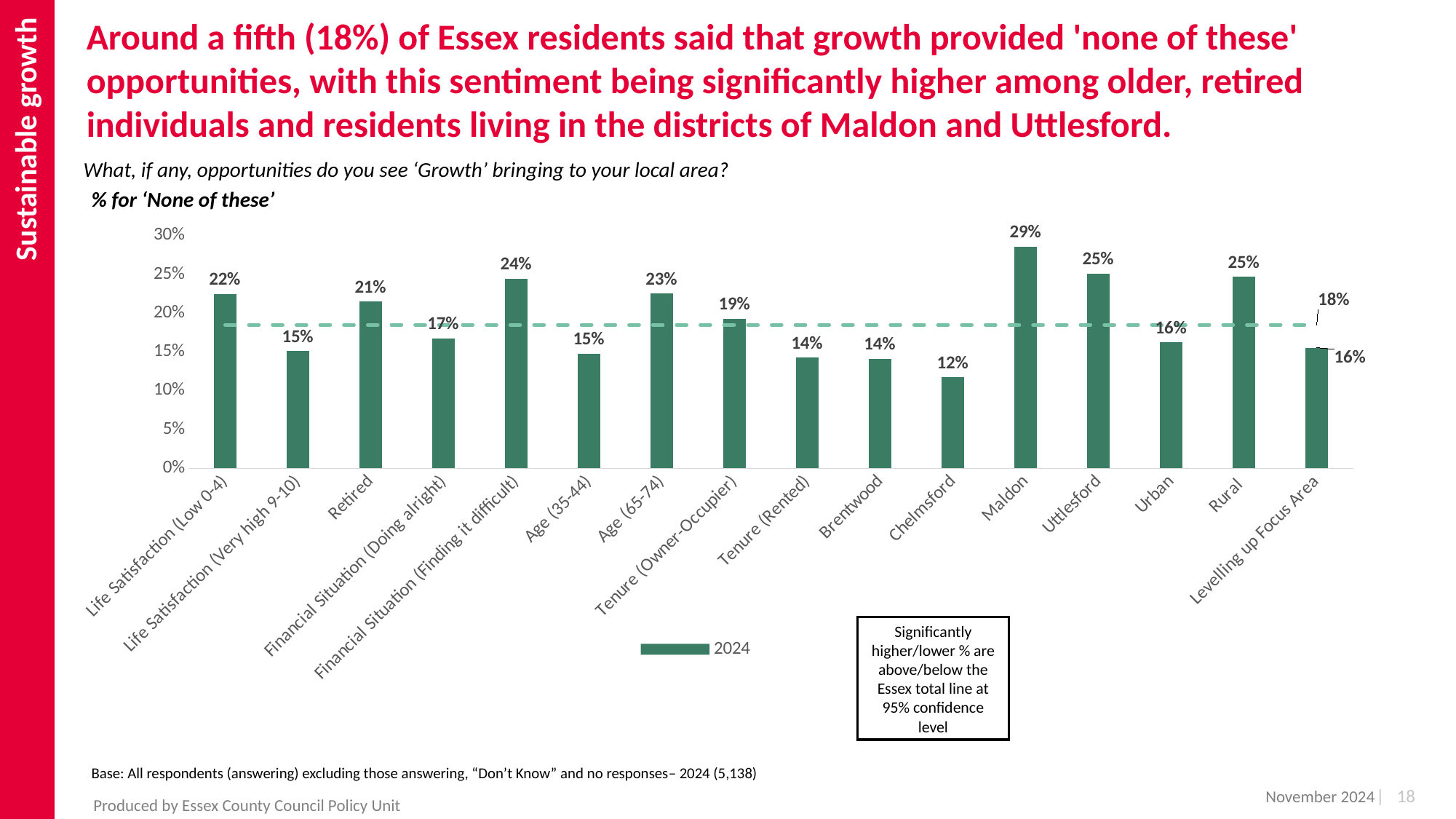
What is the value for Maldon? 29% What value does the dashed horizontal line (Essex total) represent? 18% What is the value for Tenure (Owner-Occupier)? 19% What is the value for Chelmsford? 12% What is the value for Financial Situation (Finding it difficult)? 24% How many series does the legend list? 1 Which is larger, the value for Retired or the value for Urban? Retired What kind of chart is shown on the slide? Bar chart Which category has the highest value? Maldon Which category has the lowest value? Chelmsford How many categories are shown on the x axis? 16 What is the difference between the values for Maldon and Chelmsford? 17%